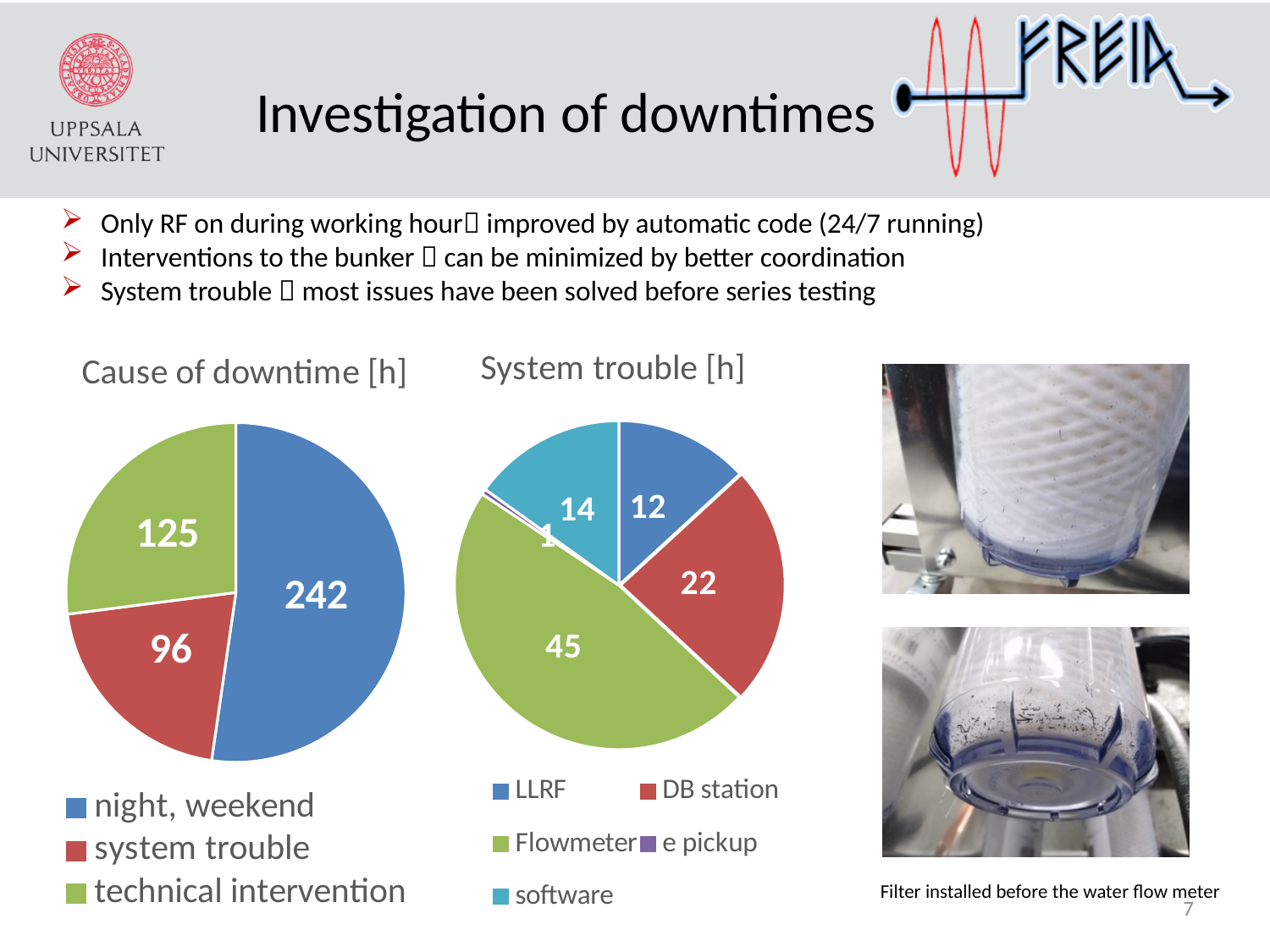
In the 'Cause of downtime [h]' chart, which category has the largest slice? night, weekend In the 'System trouble [h]' chart, which category has the smallest slice? e pickup In the 'System trouble [h]' chart, which is larger, LLRF or software? software In the 'System trouble [h]' chart, what is the value for DB station? 22 In the 'Cause of downtime [h]' chart, what is the value for night, weekend? 242 In the 'System trouble [h]' chart, what is the value for Flowmeter? 45 In the 'Cause of downtime [h]' chart, what is the value for system trouble? 96 In the 'System trouble [h]' chart, how many categories does the legend list? 5 What kind of chart is the 'Cause of downtime [h]' chart? pie chart In the 'System trouble [h]' chart, what colour is the Flowmeter slice? green In the 'Cause of downtime [h]' chart, what is the difference between technical intervention and system trouble? 29 In the 'Cause of downtime [h]' chart, what is the total of all slices? 463